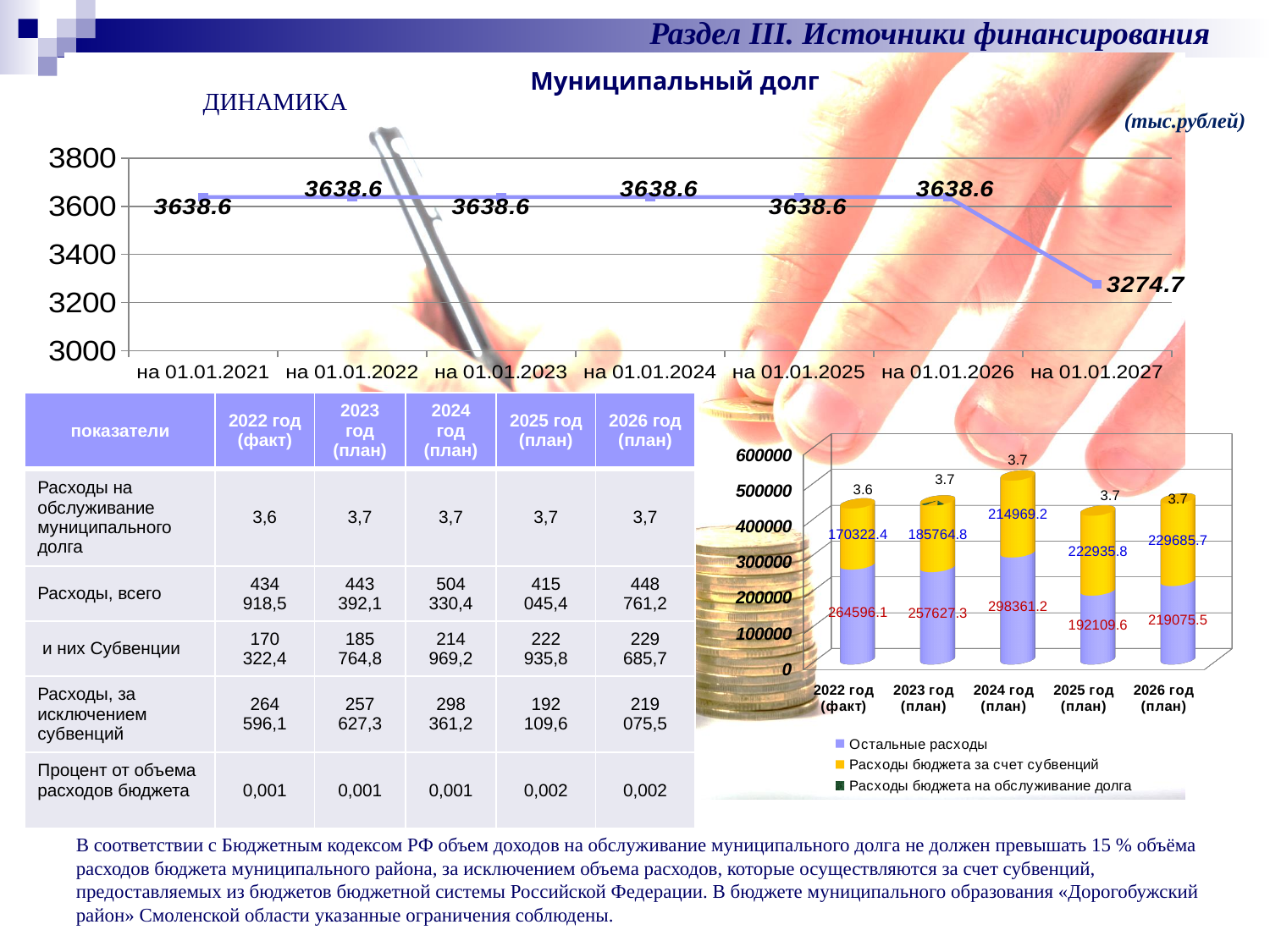
On the stacked bar chart at the bottom right, for 2025 год (план), which is larger: 'Остальные расходы' or 'Расходы бюджета за счет субвенций'? Расходы бюджета за счет субвенций On the top chart 'Муниципальный долг', how many data points are plotted? 7 On the stacked bar chart at the bottom right, what is the value of 'Остальные расходы' for 2024 год (план)? 298361.2 On the stacked bar chart at the bottom right, how many series does the legend list? 3 On the top chart 'Муниципальный долг', what is the value for на 01.01.2021? 3638.6 On the top chart 'Муниципальный долг', which date has the lowest value? на 01.01.2027 On the stacked bar chart at the bottom right, what is the value of 'Расходы бюджета за счет субвенций' for 2026 год (план)? 229685.7 On the stacked bar chart at the bottom right, which year has the highest value for 'Остальные расходы'? 2024 год (план) On the top chart 'Муниципальный долг', what is the difference between the values for на 01.01.2026 and на 01.01.2027? 363.9 On the top chart 'Муниципальный долг', what is the value for на 01.01.2027? 3274.7 On the top chart 'Муниципальный долг', do the values rise or fall from на 01.01.2026 to на 01.01.2027? fall On the top chart titled 'Муниципальный долг', what kind of chart is it? line chart